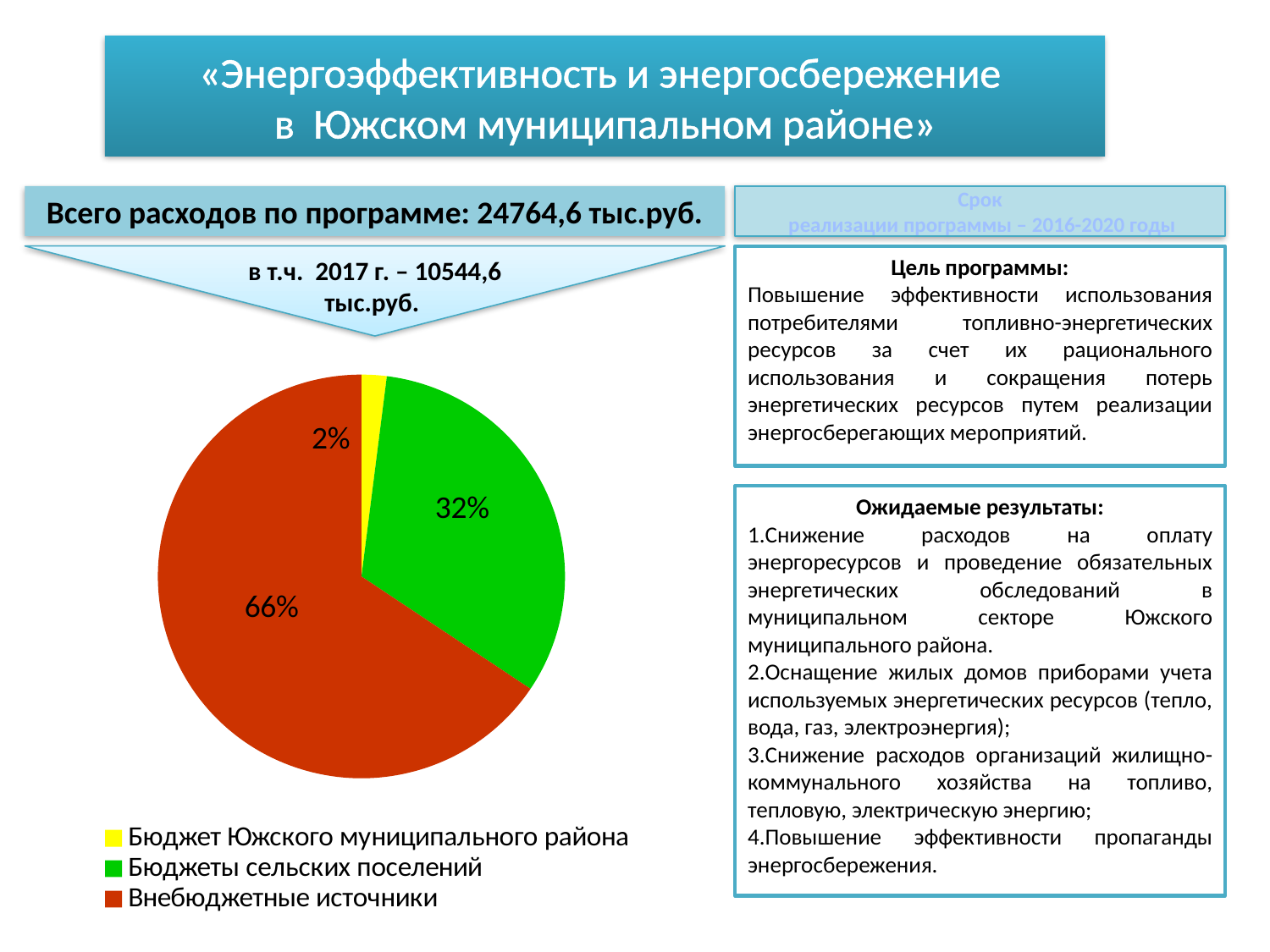
What colour is the slice for Бюджет Южского муниципального района? Yellow What is the combined share of Бюджеты сельских поселений and Бюджет Южского муниципального района? 34% How many slices does the pie chart have? 3 What is the difference in percentage points between Внебюджетные источники and Бюджеты сельских поселений? 34 Which category has the smallest slice of the pie? Бюджет Южского муниципального района What colour is the slice for Внебюджетные источники? Red Which category has the largest slice of the pie? Внебюджетные источники Which is larger: the share for Бюджеты сельских поселений or the share for Бюджет Южского муниципального района? Бюджеты сельских поселений What share of the pie does Внебюджетные источники account for? 66% What kind of chart is shown on the slide? Pie chart What share of the pie does Бюджет Южского муниципального района account for? 2% What share of the pie does Бюджеты сельских поселений account for? 32%